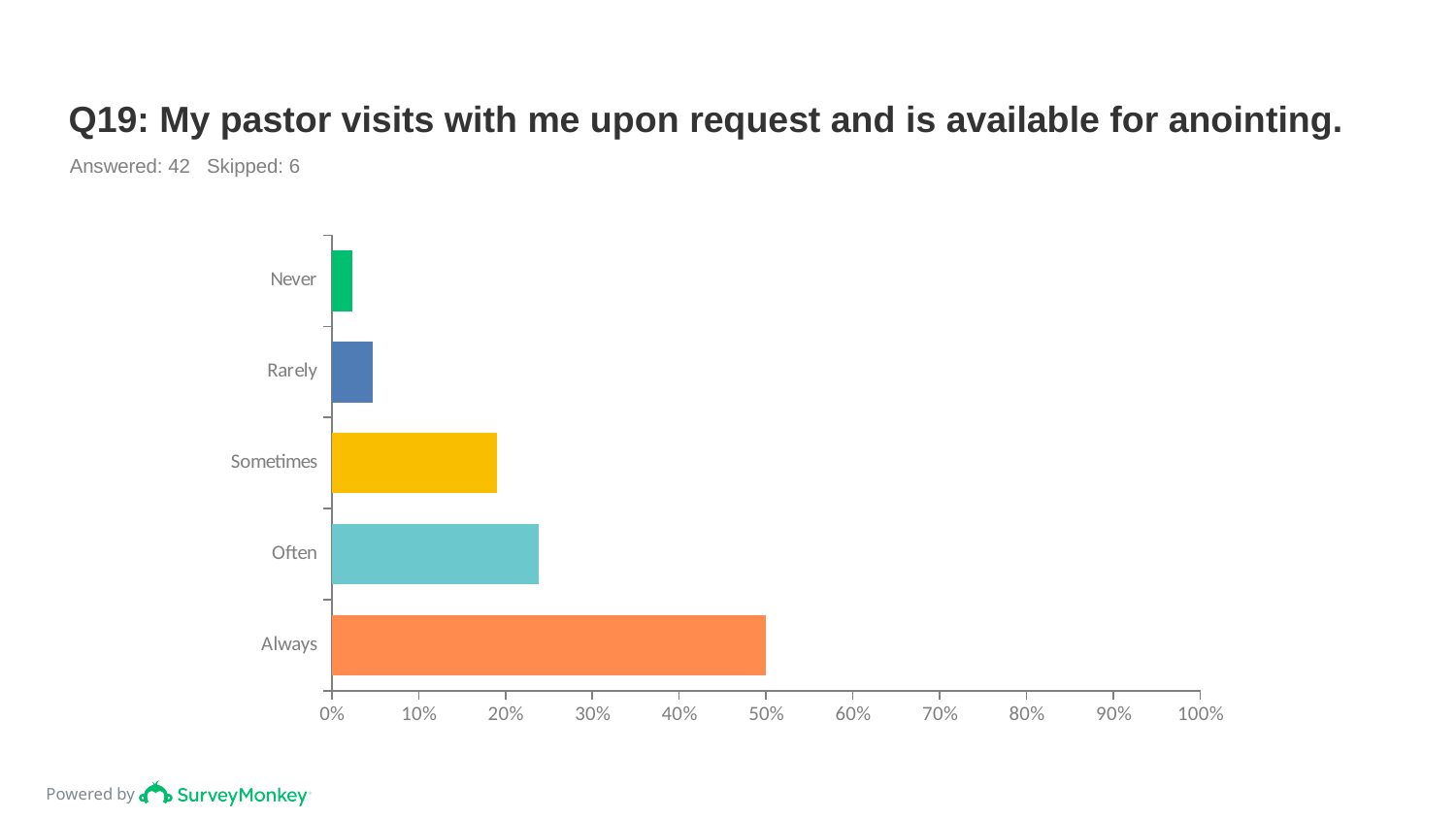
What is the title of the chart? Q19: My pastor visits with me upon request and is available for anointing. Is the value for Often greater or less than 20%? greater How many categories are plotted in the chart? 5 Is the value for Rarely greater or less than 10%? less What is the value for Always? 50% Which is larger, the value for Often or the value for Sometimes? Often What kind of chart is shown on the slide? bar chart How many respondents answered this question according to the slide? 42 Which category has the highest value? Always Which is larger, the value for Rarely or the value for Never? Rarely Which category has the lowest value? Never